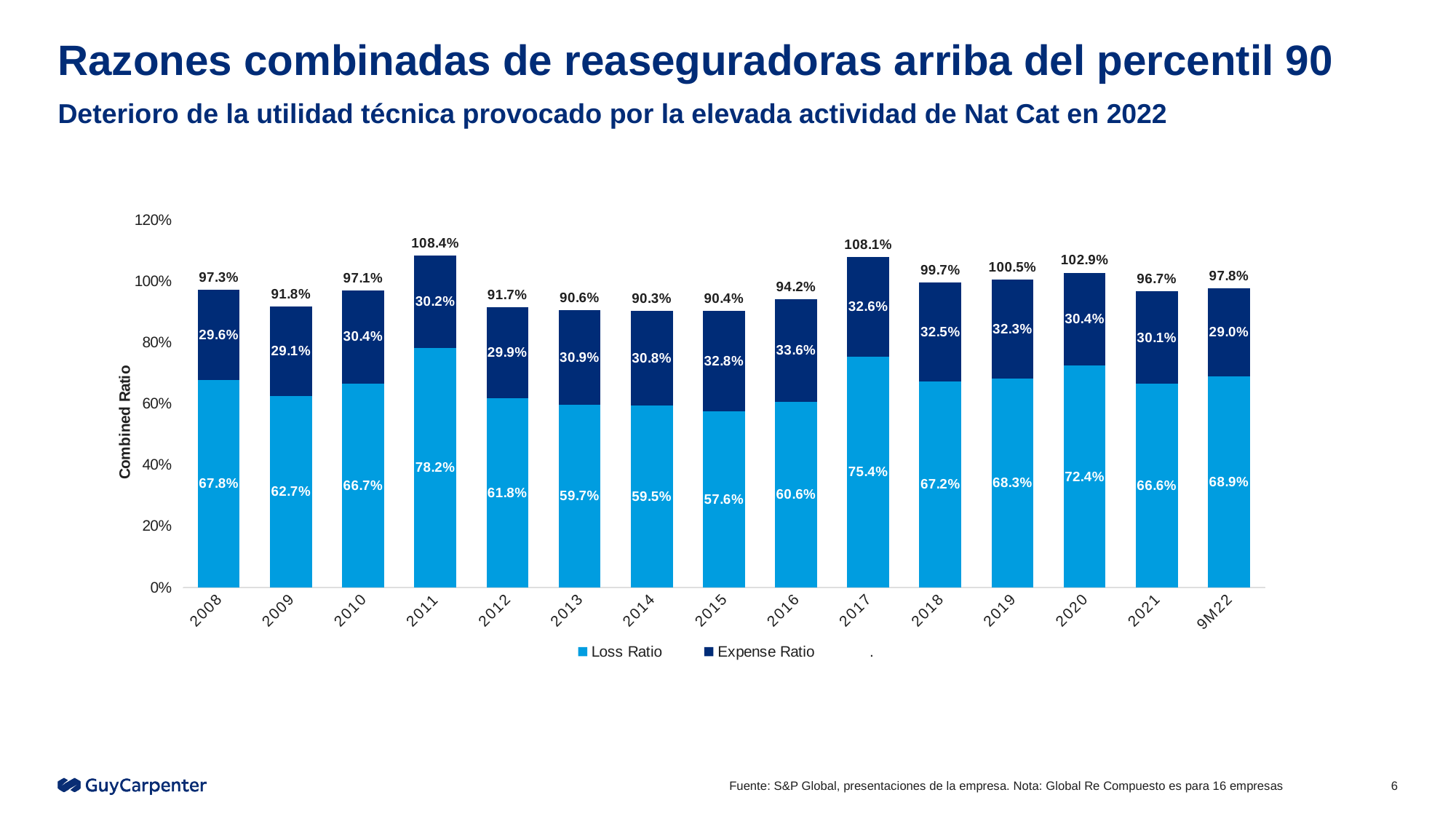
What is the combined ratio total shown above the bar for 2020? 102.9% Which year has the lowest Loss Ratio? 2015 What is the Expense Ratio for 2016? 33.6% What is the label on the vertical axis? Combined Ratio How many series does the legend list? 2 Which is larger, the Expense Ratio in 2017 or the Expense Ratio in 2008? Expense Ratio in 2017 How many periods are shown on the x axis? 15 What kind of chart is shown on the slide? Stacked bar chart What is the Loss Ratio for 2011? 78.2% Is the combined ratio total for 2013 greater or less than 100%? less Which year has the highest combined ratio total? 2011 What is the difference between the Loss Ratio in 2017 and the Loss Ratio in 2016? 14.8%